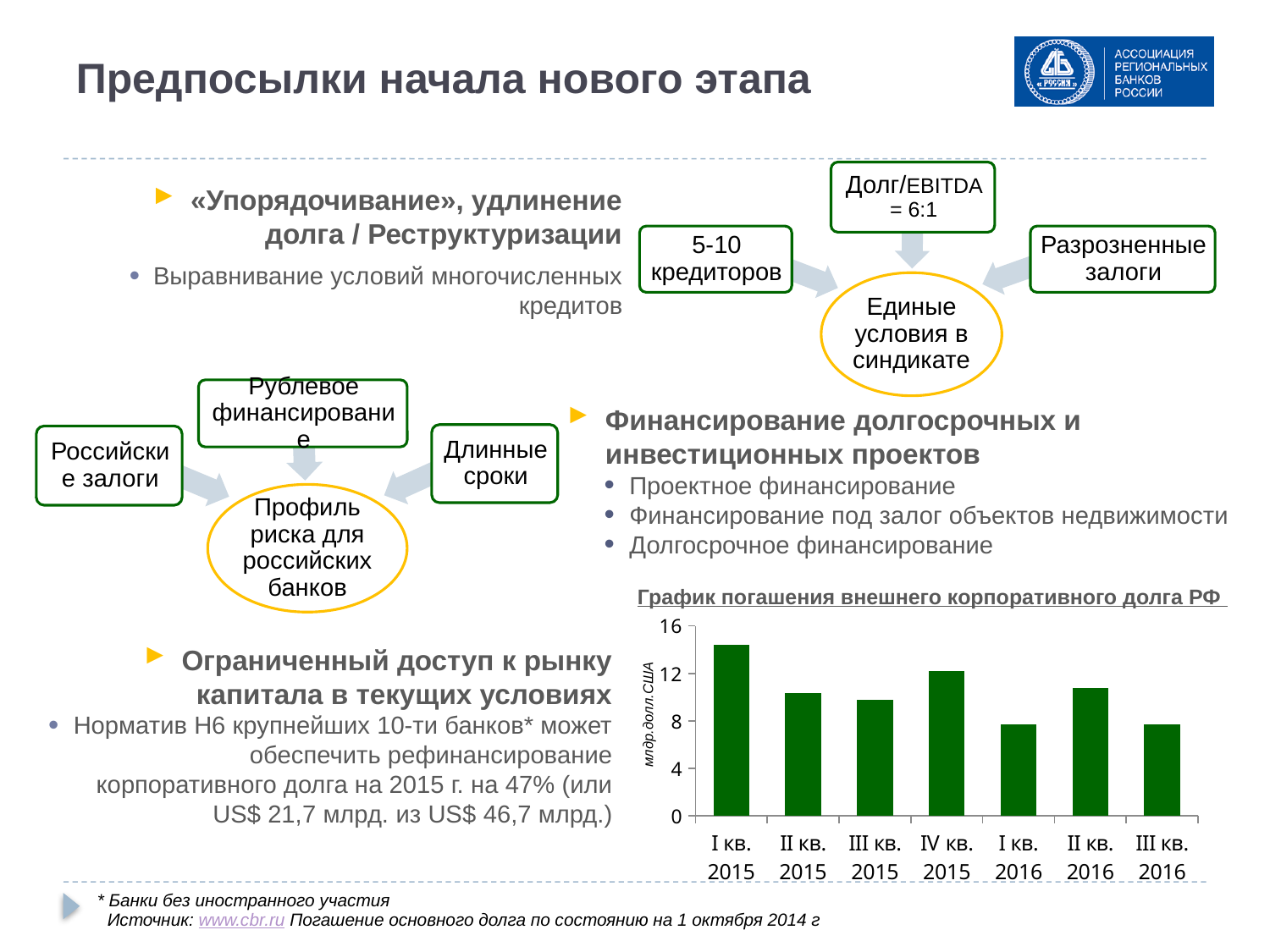
In the chart 'График погашения внешнего корпоративного долга РФ', is the value for III кв. 2015 greater or less than 12? less What unit is shown on the vertical axis label of the chart 'График погашения внешнего корпоративного долга РФ'? млрд.долл.США In the chart 'График погашения внешнего корпоративного долга РФ', which is larger: the value for III кв. 2015 or IV кв. 2015? IV кв. 2015 In the chart 'График погашения внешнего корпоративного долга РФ', which is larger: the value for I кв. 2015 or II кв. 2015? I кв. 2015 In the chart 'График погашения внешнего корпоративного долга РФ', is the value for I кв. 2015 greater or less than 12? greater What kind of chart is shown under the title 'График погашения внешнего корпоративного долга РФ'? bar chart In the chart 'График погашения внешнего корпоративного долга РФ', is the value for II кв. 2015 greater or less than 8? greater In the chart 'График погашения внешнего корпоративного долга РФ', which is larger: the value for I кв. 2016 or II кв. 2016? II кв. 2016 How many quarters (bars) are plotted in the chart 'График погашения внешнего корпоративного долга РФ'? 7 In the chart 'График погашения внешнего корпоративного долга РФ', which quarter has the highest value? I кв. 2015